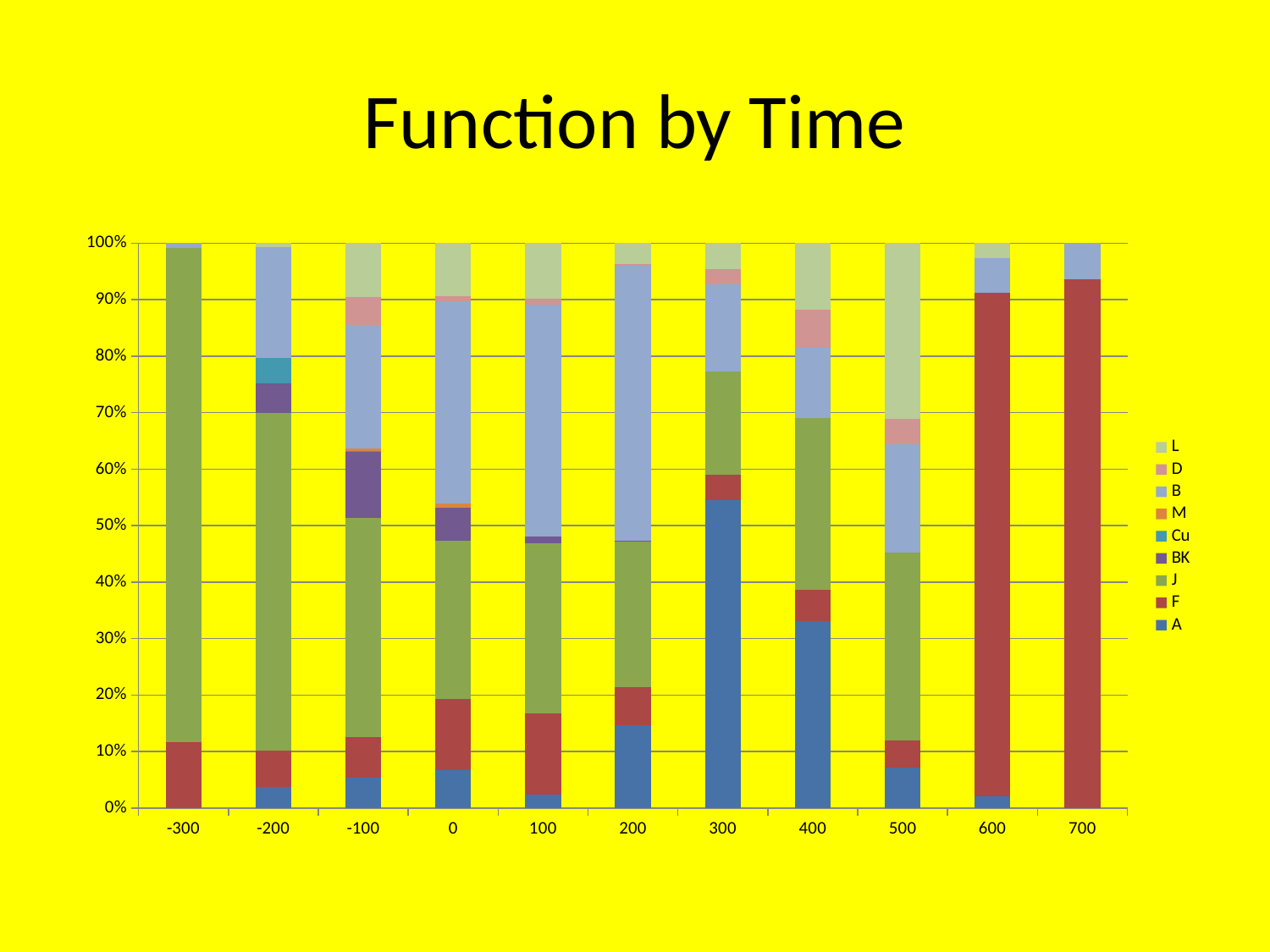
Is the value for series A at category 300 greater or less than 50%? greater Is the value for series J at category -300 greater or less than 80%? greater What is the title of the chart? Function by Time How many categories are shown along the x axis? 11 How many series does the legend list? 9 Is the value for series A at category 400 greater or less than 30%? greater What kind of chart is shown on the slide? stacked bar chart Which category has the largest share for series A? 300 Which is larger: the share of series A at category 300 or at category 400? 300 What is the total height of each stacked bar on the y axis? 100% In which category does the series Cu appear? -200